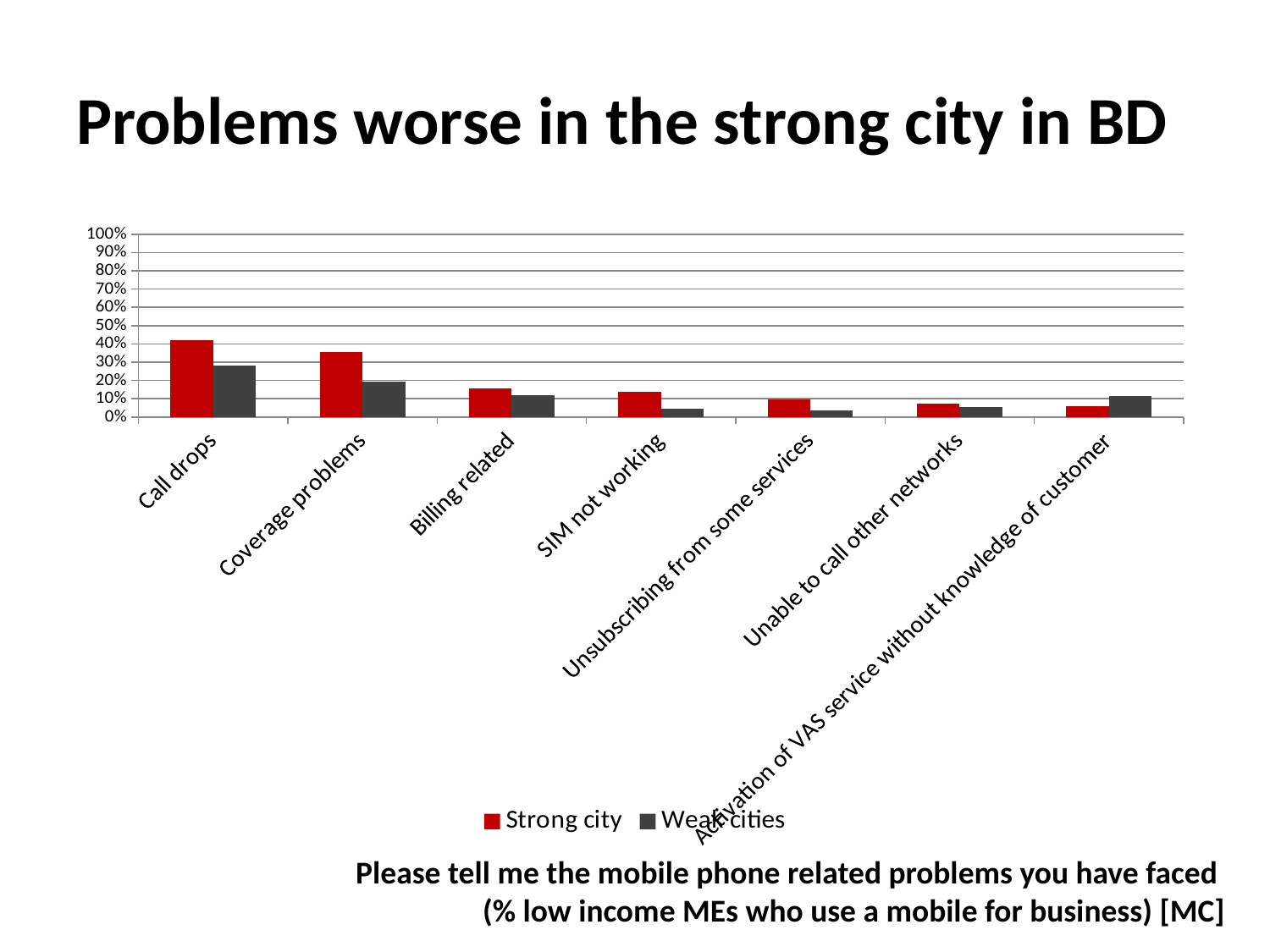
Is the Strong city value for Call drops greater or less than 30%? greater Is the Weak cities value for Call drops greater or less than 20%? greater For Activation of VAS service without knowledge of customer, which series has the larger value, Strong city or Weak cities? Weak cities Is the Strong city value for Billing related greater or less than 20%? less How many problem categories are shown on the x axis? 7 Which category has the highest value for Weak cities? Call drops What kind of chart is shown on the slide? bar chart Which colour represents the Strong city series in the legend? red How many series does the legend list? 2 Which category has the highest value for Strong city? Call drops